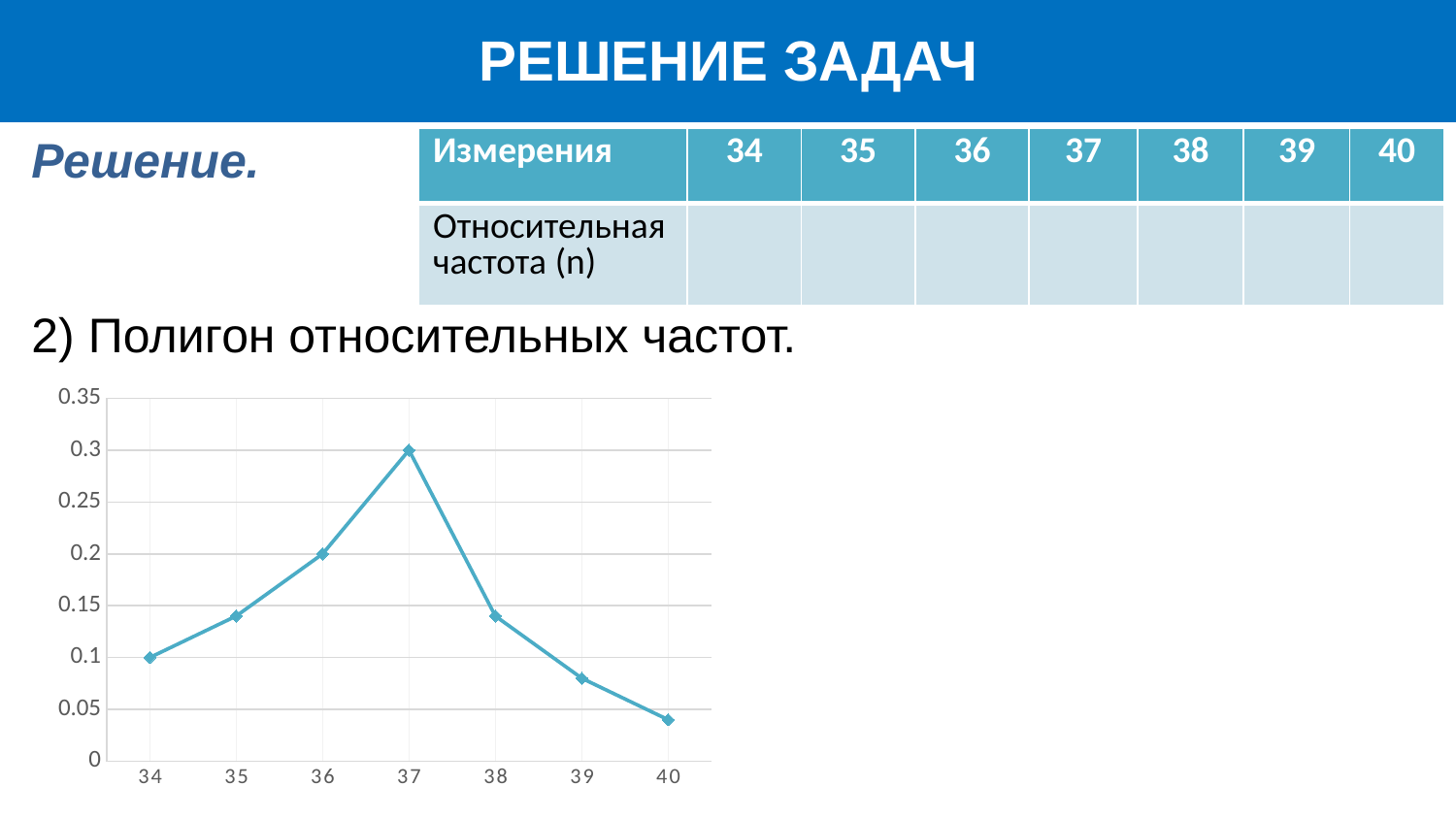
What is the value plotted for 36? 0.2 Which x-axis category has the highest value? 37 How many data points are plotted on the line chart? 7 What kind of chart is shown on the slide? line chart Is the value for 39 greater or less than 0.1? less Do the values rise or fall from 37 to 40 along the x axis? fall Is the value for 38 greater or less than 0.1? greater What is the value plotted for 37? 0.3 Which has the larger value, 36 or 38? 36 Which x-axis category has the lowest value? 40 What is the value plotted for 34? 0.1